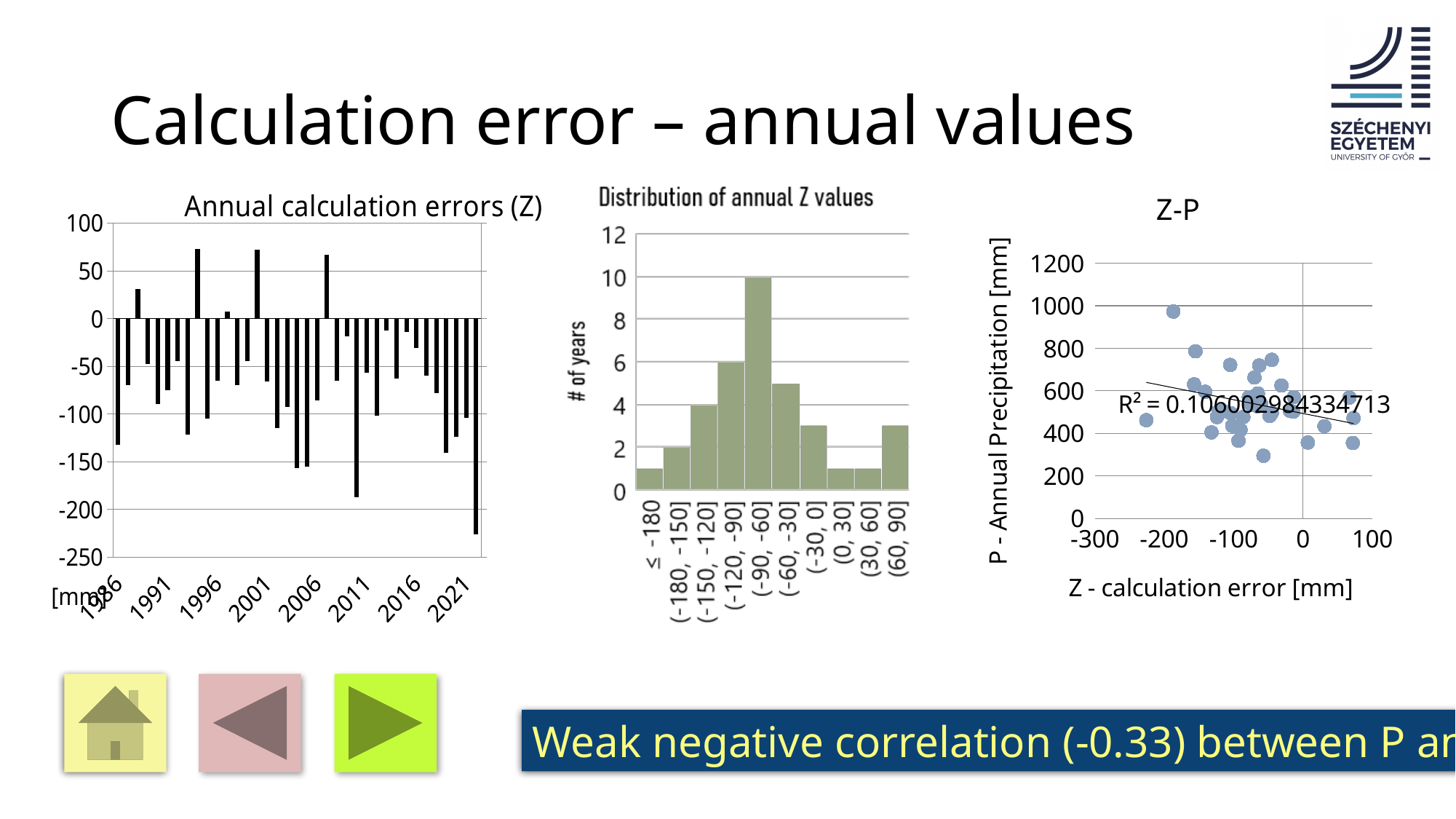
In the 'Distribution of annual Z values' chart, how many years fall in the (-90, -60] bin? 10 In the 'Distribution of annual Z values' chart, which bin has the highest number of years? (-90, -60] In the 'Distribution of annual Z values' chart, how many bins are shown on the x axis? 10 In the 'Distribution of annual Z values' chart, how many years fall in the (-150, -120] bin? 4 In the 'Distribution of annual Z values' chart, which is larger: the (-60, -30] bin or the (-30, 0] bin? (-60, -30] In the 'Annual calculation errors (Z)' chart, is the value for 1986 greater or less than -100? less In the 'Distribution of annual Z values' chart, how many years fall in the (-120, -90] bin? 6 What kind of chart is the 'Z-P' chart? scatter plot What kind of chart is the 'Distribution of annual Z values' chart? bar chart In the 'Distribution of annual Z values' chart, is the value for the (0, 30] bin greater or less than 2? less What R² value is printed on the 'Z-P' chart? R² = 0.106002984334713 In the 'Distribution of annual Z values' chart, how many years fall in the (-180, -150] bin? 2